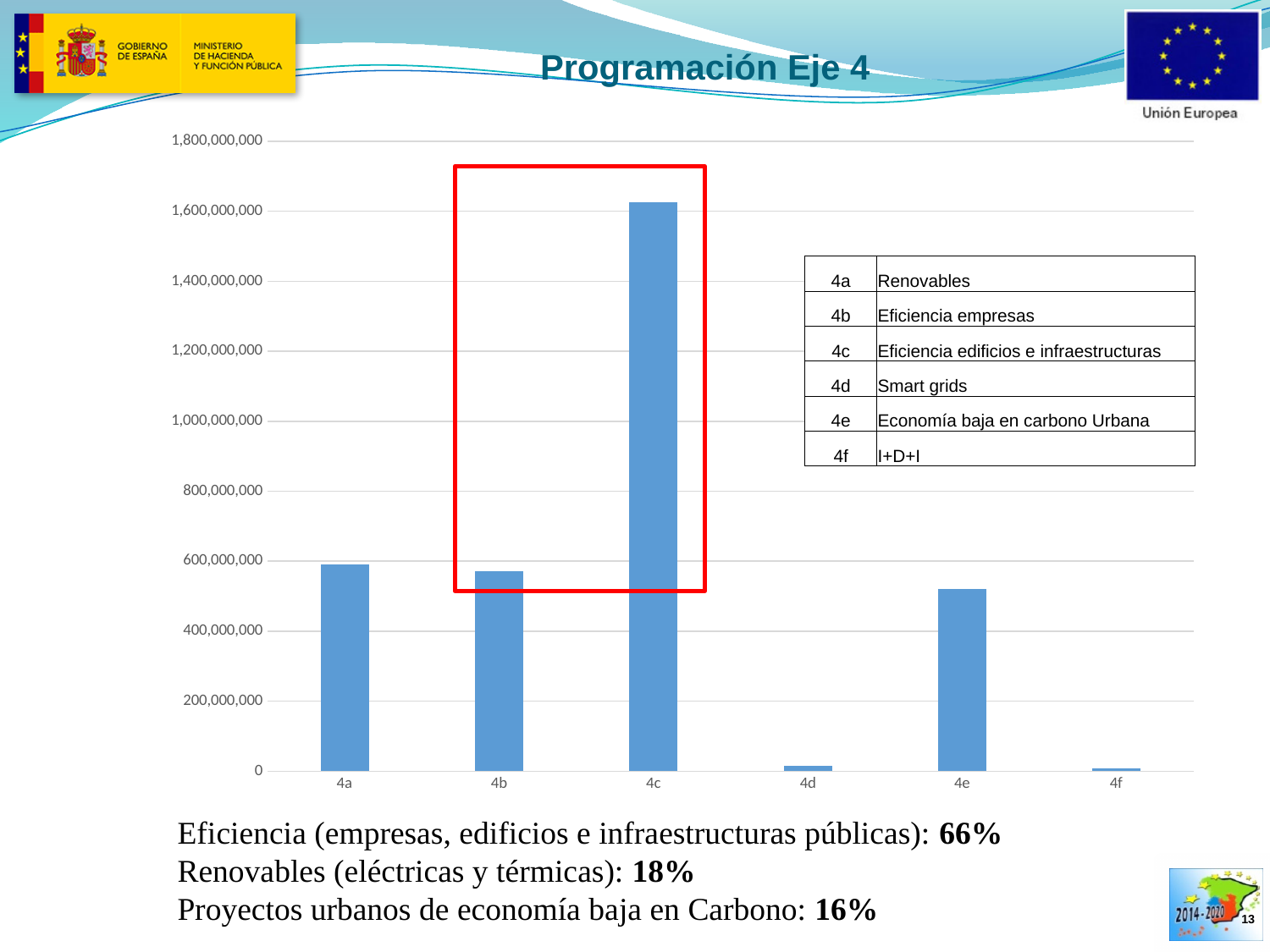
How many categories are plotted on the x axis of the chart? 6 Which category has the highest bar in the chart? 4c According to the table next to the chart, what does category 4c stand for? Eficiencia edificios e infraestructuras What kind of chart is shown on the slide? bar chart Is the value for 4d greater or less than 200,000,000? less Is the value for 4c greater or less than 1,400,000,000? greater Which is larger, the value for 4a or the value for 4e? 4a What is the title of the slide containing the chart? Programación Eje 4 Which category has the lowest bar in the chart? 4f Which is larger, the value for 4c or the value for 4e? 4c Is the value for 4e greater or less than 600,000,000? less